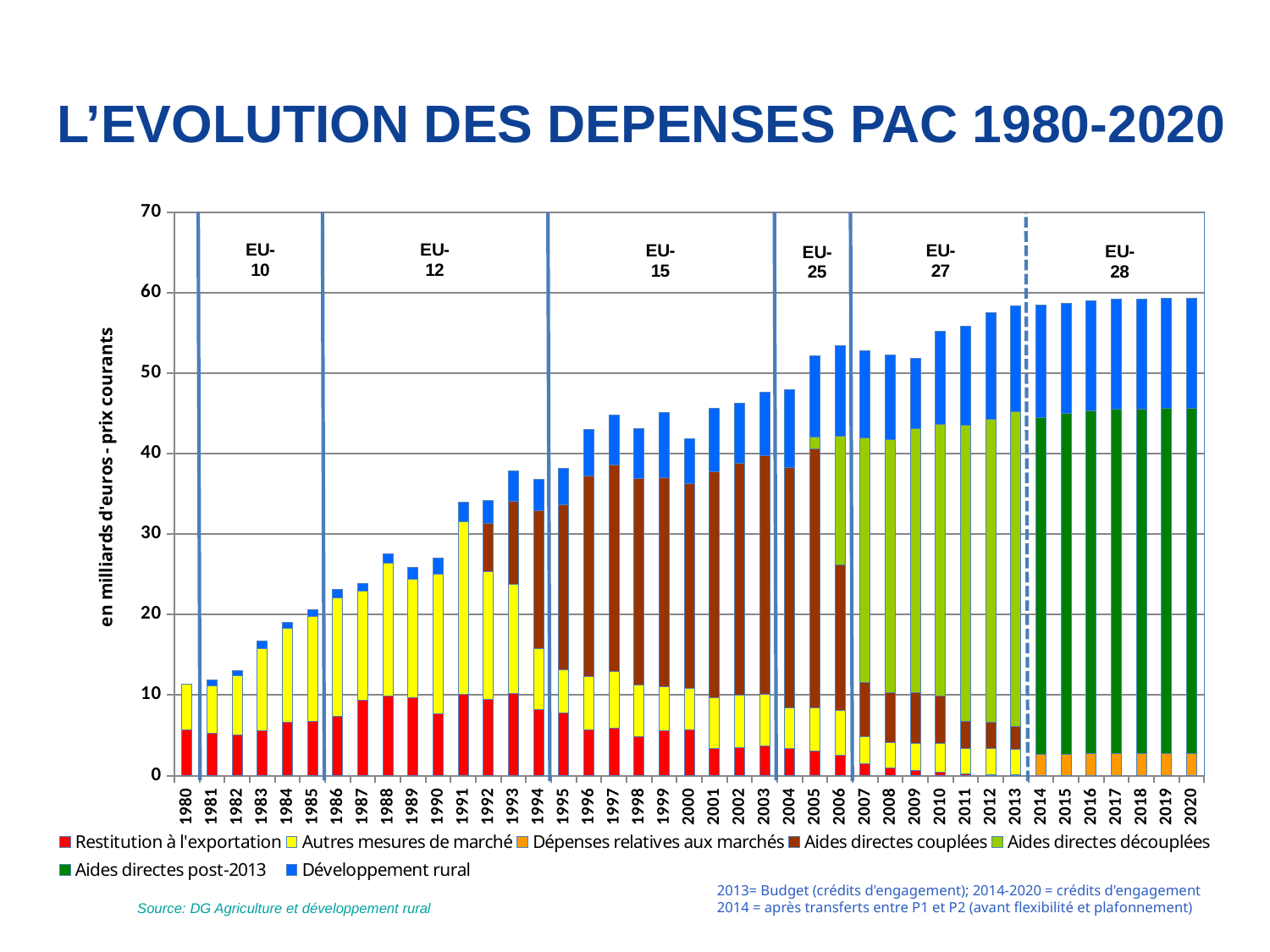
Is the total value for 2010 greater or less than 50? greater Which year has the larger total, 1990 or 2000? 2000 How many series does the legend list? 7 How many years (bars) are plotted along the x axis? 41 What is the title of the chart? L'EVOLUTION DES DEPENSES PAC 1980-2020 What is the label of the y axis? en milliards d'euros - prix courants What kind of chart is shown on the slide? stacked bar chart Is the total value for 1990 greater or less than 30? less Do the total bar heights generally rise or fall from 1980 to 2020? rise Is the total value for 2020 greater or less than 50? greater Which year has the larger total, 1980 or 2020? 2020